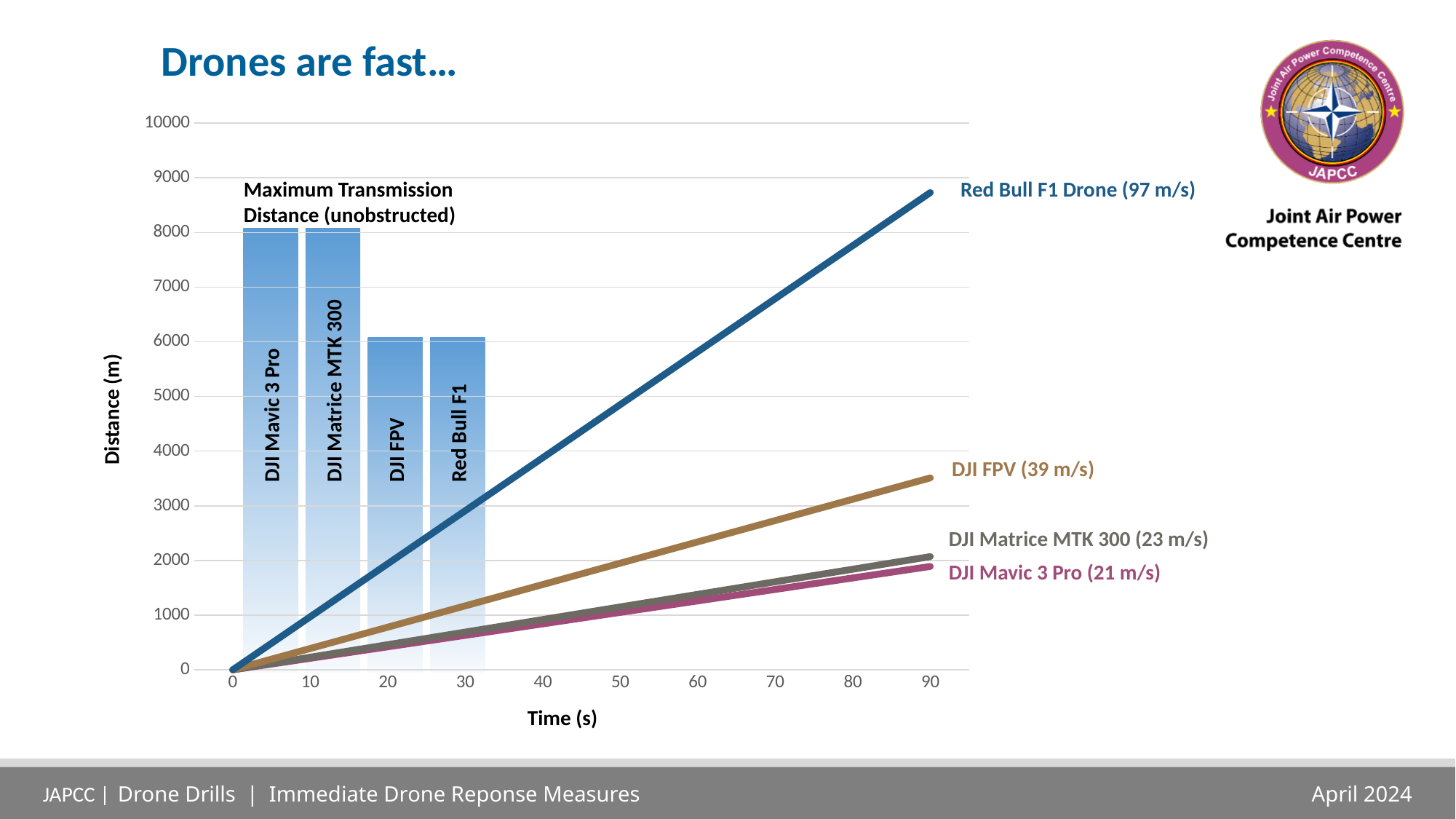
What speed is given for the DJI FPV in its line label? 39 m/s What speed is given for the Red Bull F1 Drone in its line label? 97 m/s Is the maximum transmission distance bar for the DJI Mavic 3 Pro greater or less than 7000? greater What speed is given for the DJI Matrice MTK 300 in its line label? 23 m/s Which is faster, the DJI Matrice MTK 300 or the DJI Mavic 3 Pro? DJI Matrice MTK 300 Which drone has the highest speed shown on the chart? Red Bull F1 Drone How many drone lines are plotted on the chart? 4 What is the label of the x axis? Time (s) What speed is given for the DJI Mavic 3 Pro in its line label? 21 m/s What is the difference in speed between the Red Bull F1 Drone and the DJI FPV? 58 m/s Is the maximum transmission distance bar for the DJI FPV greater or less than 7000? less Which drone has the lowest speed shown on the chart? DJI Mavic 3 Pro